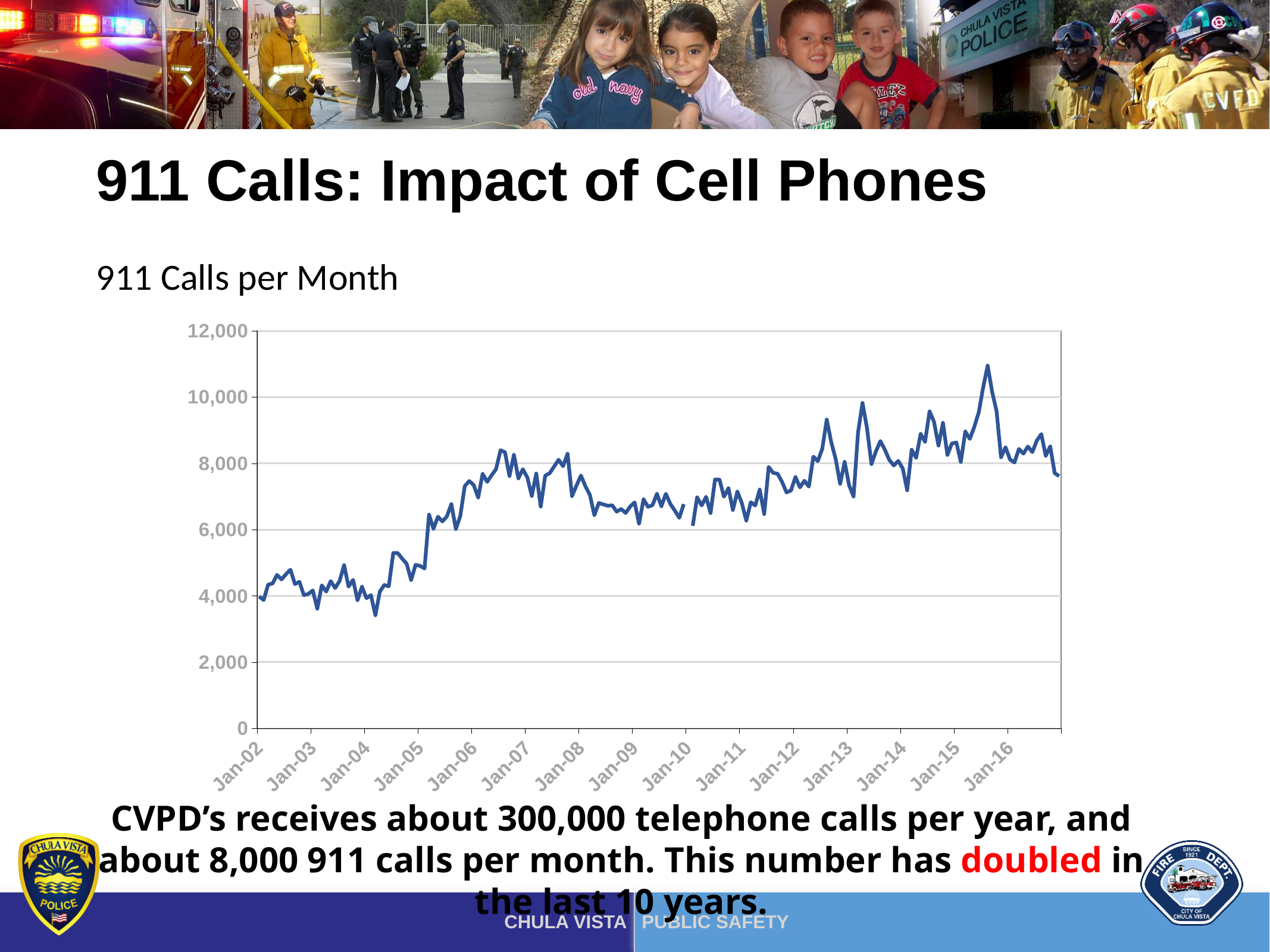
Is the value at Jan-07 greater or less than 6,000? greater What is the highest value shown on the chart's vertical axis? 12,000 Is the highest peak on the chart greater or less than 10,000? greater What kind of chart is shown on the slide? line chart Overall, do 911 calls per month rise or fall from Jan-02 to the end of the chart? rise Which is larger, the value at Jan-02 or the value at Jan-16? Jan-16 Is the value at Jan-02 greater or less than 6,000? less What is the title of the chart? 911 Calls per Month How many year labels (Jan-02 through Jan-16) are shown on the x axis? 15 In which year does the line reach its highest point? 2015 How many lines are plotted on the chart? 1